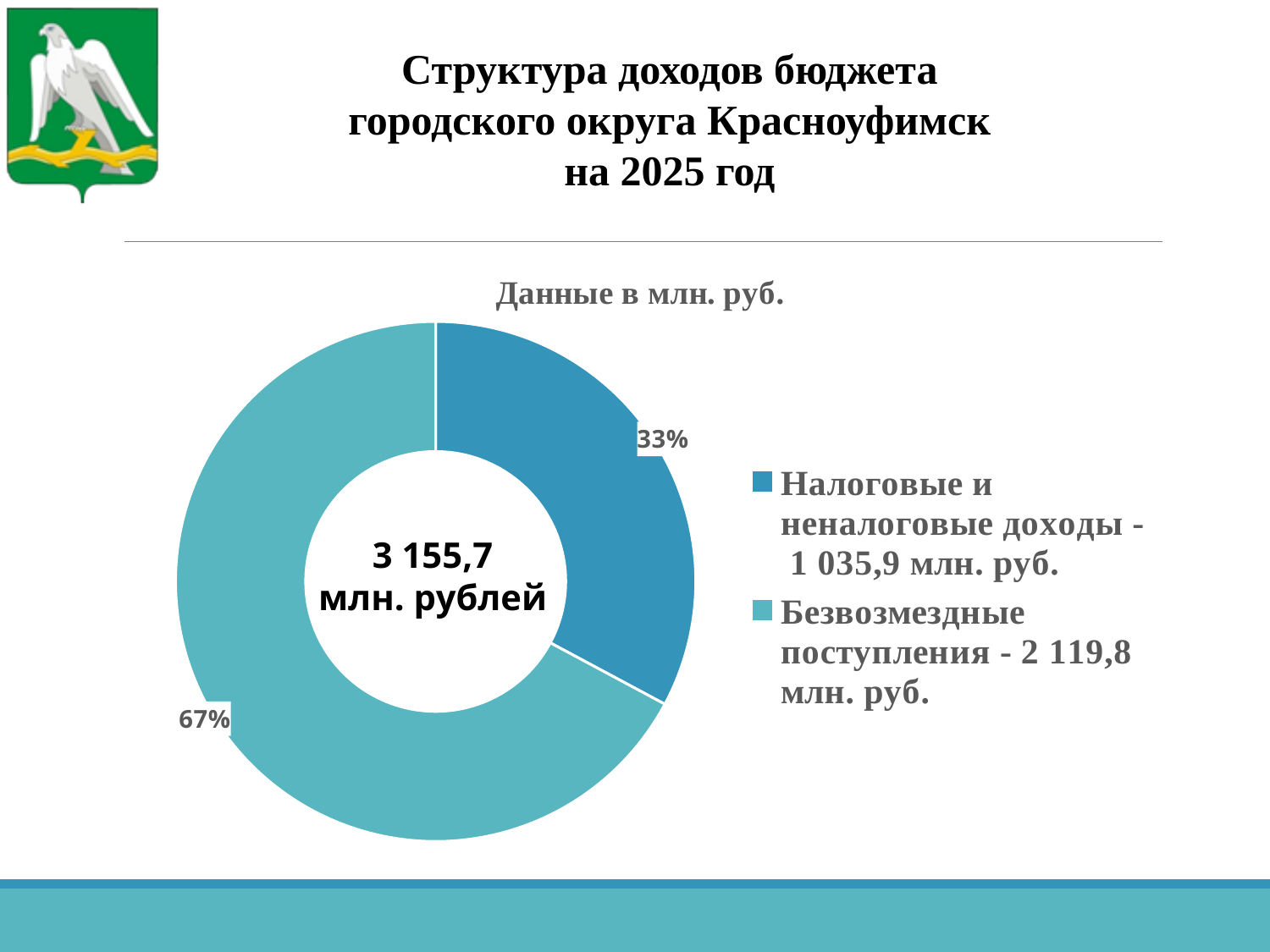
What share of the pie does the slice for Налоговые и неналоговые доходы represent? 33% What share of the pie does the slice for Безвозмездные поступления represent? 67% What kind of chart is shown on the slide? Pie (doughnut) chart Which category has the largest slice of the pie? Безвозмездные поступления Which category has the smallest slice of the pie? Налоговые и неналоговые доходы What value is given in the legend for Безвозмездные поступления? 2 119,8 млн. руб. What is the title printed above the chart? Данные в млн. руб. Which is larger: Безвозмездные поступления or Налоговые и неналоговые доходы? Безвозмездные поступления What total value is shown in the centre of the chart? 3 155,7 млн. рублей How many categories does the chart show? 2 What value is given in the legend for Налоговые и неналоговые доходы? 1 035,9 млн. руб. What is the difference in percentage points between the 67% slice and the 33% slice? 34 percentage points